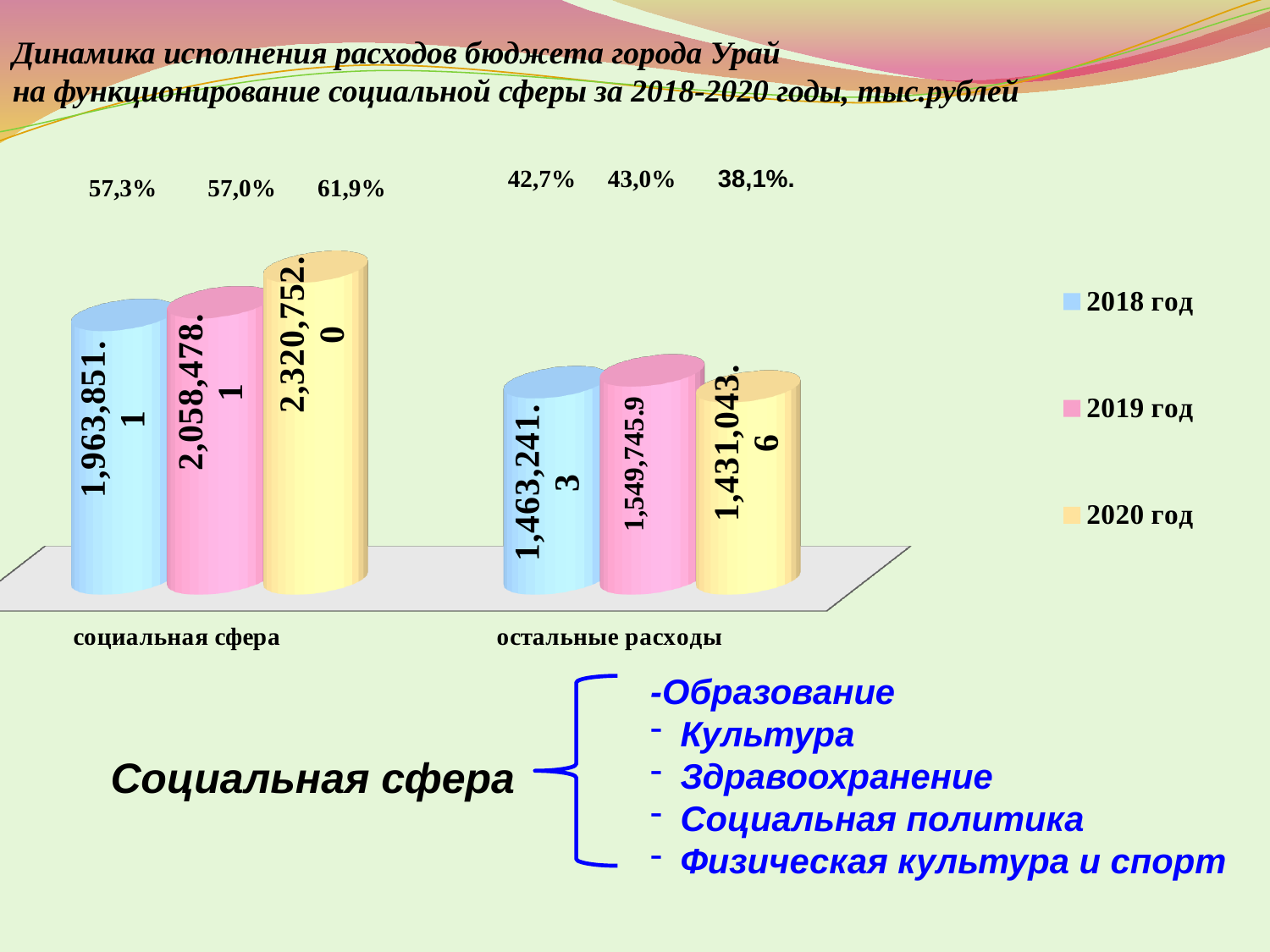
What is the value for социальная сфера in 2020 год? 2,320,752.0 What is the difference between the 2019 год and 2020 год values for остальные расходы? 118,702.3 How many categories are shown on the x axis? 2 Which year has the lowest value for остальные расходы? 2020 год Which year has the highest value for социальная сфера? 2020 год Which is larger: социальная сфера in 2019 год or остальные расходы in 2019 год? социальная сфера in 2019 год What is the difference between the 2020 год and 2018 год values for социальная сфера? 356,900.9 What kind of chart is shown on the slide? Bar chart What is the value for остальные расходы in 2020 год? 1,431,043.6 What is the value for остальные расходы in 2019 год? 1,549,745.9 How many series does the legend list? 3 What is the value for социальная сфера in 2018 год? 1,963,851.1